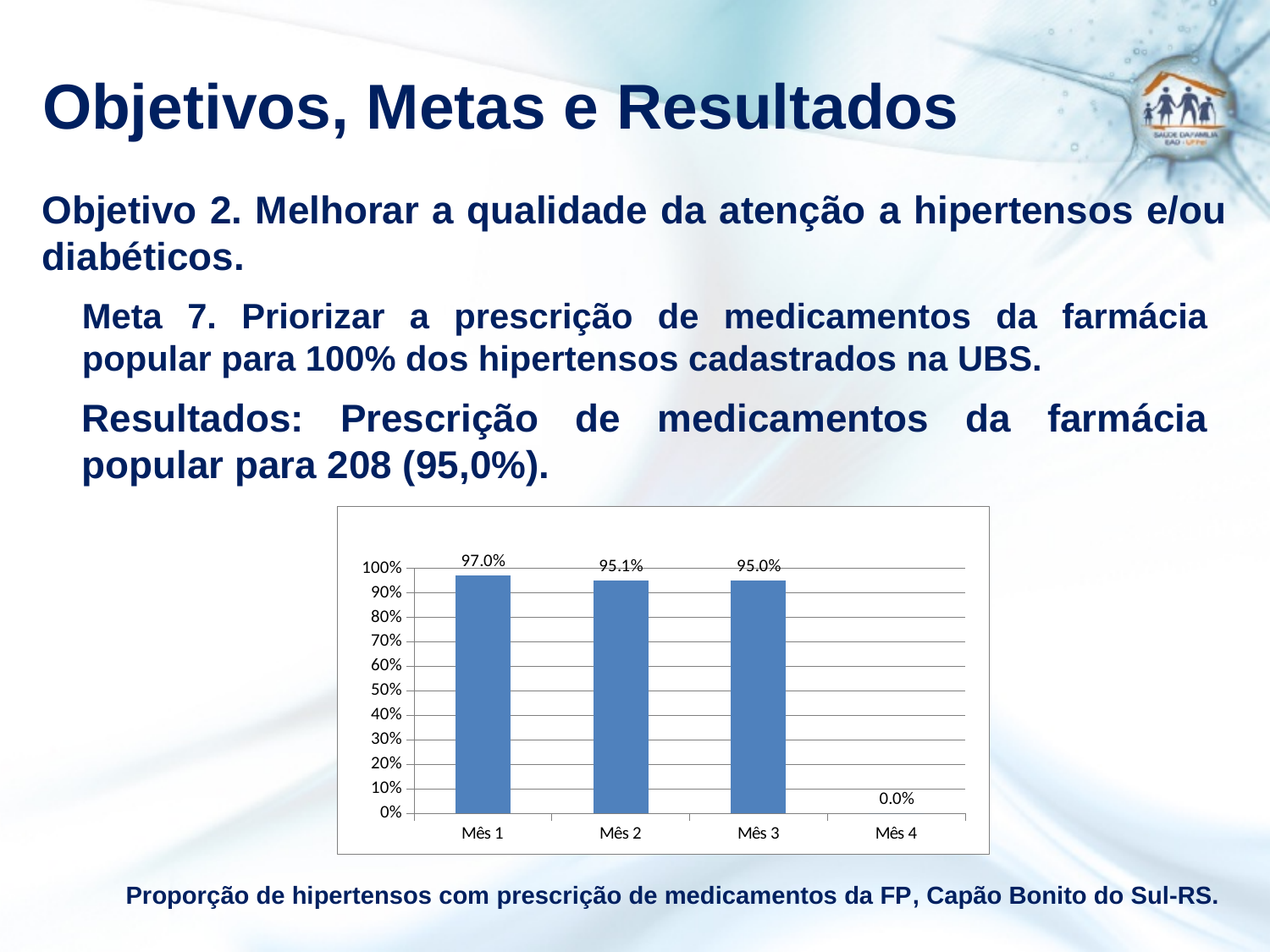
Which is larger, the value for Mês 1 or the value for Mês 4? Mês 1 What kind of chart is shown on the slide? bar chart Which month has the highest value? Mês 1 How many months are shown on the x axis? 4 What is the value for Mês 2? 95.1% What is the value for Mês 4? 0.0% Which month has the lowest value? Mês 4 What is the difference between the values for Mês 1 and Mês 2? 1.9% What is the value for Mês 1? 97.0% Is the value for Mês 2 greater or less than 90%? greater What is the difference between the values for Mês 1 and Mês 3? 2.0% What is the value for Mês 3? 95.0%